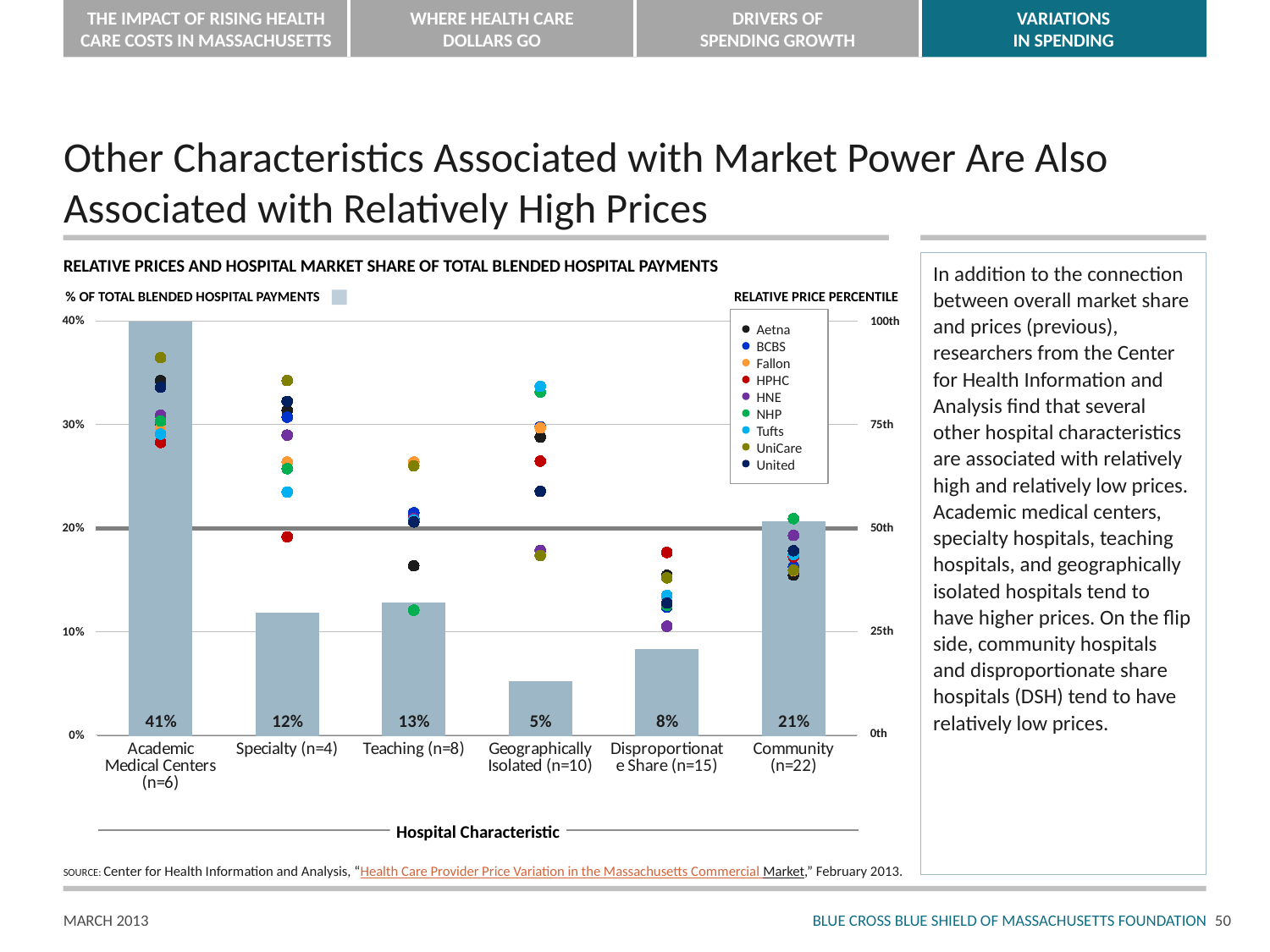
Are the relative price percentile dots for Disproportionate Share (n=15) hospitals above or below the 50th percentile line? below What percentage of total blended hospital payments goes to Community hospitals (n=22)? 21% How many hospital characteristic categories are shown on the x axis? 6 Which has a larger share of total blended hospital payments, Teaching (n=8) or Specialty (n=4)? Teaching (n=8) What percentage of total blended hospital payments goes to Academic Medical Centers (n=6)? 41% Which hospital characteristic has the lowest share of total blended hospital payments? Geographically Isolated (n=10) Which hospital characteristic has the highest share of total blended hospital payments? Academic Medical Centers (n=6) What is the title of the chart? Relative Prices and Hospital Market Share of Total Blended Hospital Payments What is the difference in share of total blended hospital payments between Academic Medical Centers and Community hospitals? 20 percentage points What percentage of total blended hospital payments goes to Geographically Isolated hospitals (n=10)? 5% How many payers are listed in the legend for the relative price percentile dots? 9 What kind of chart is used to show the % of total blended hospital payments? Bar chart